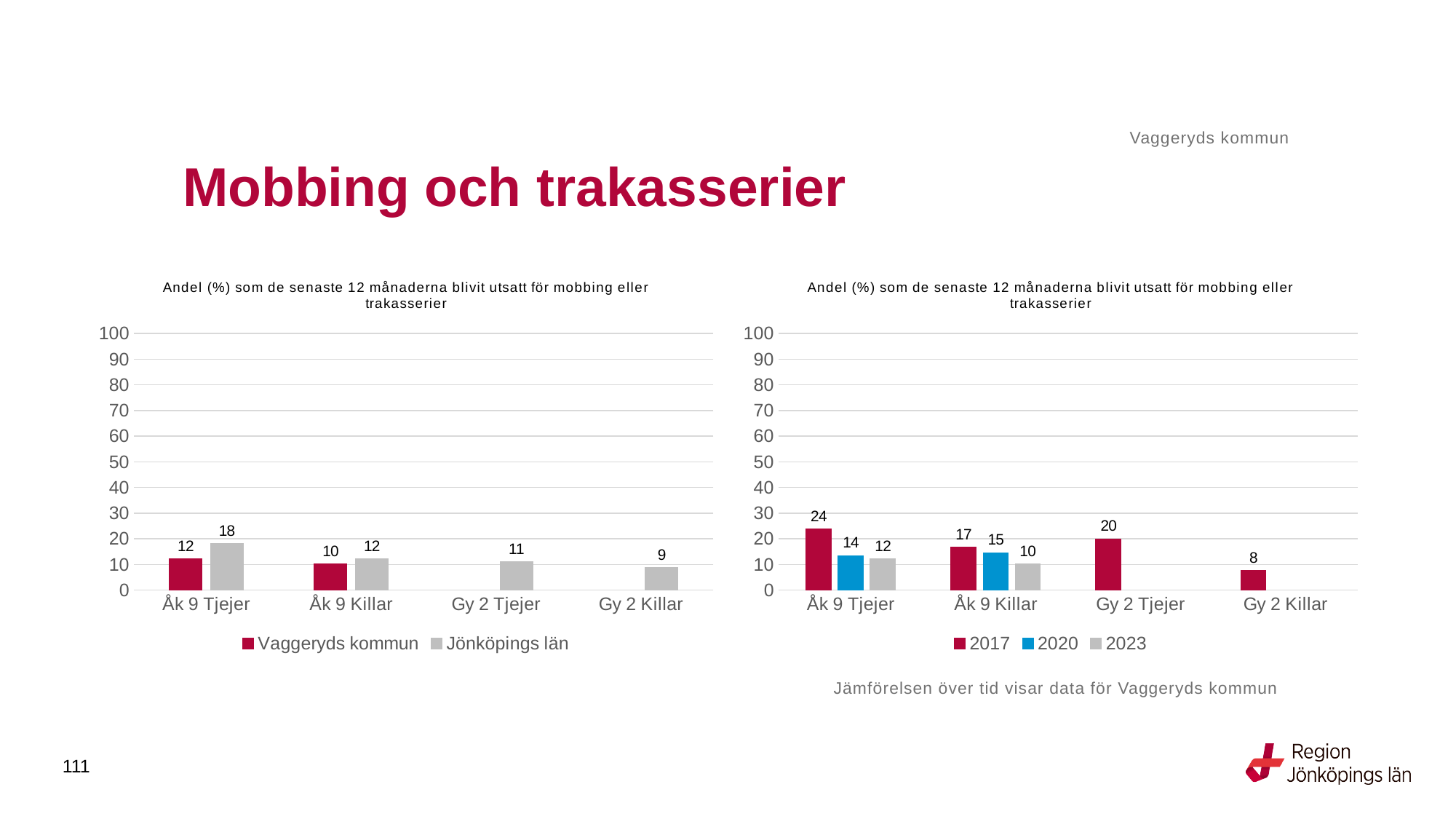
In the right chart, what is the value for 2023 for Åk 9 Killar? 10 In the left chart, how many series does the legend list? 2 In the right chart, which is larger for Åk 9 Killar: the 2020 value or the 2023 value? 2020 In the left chart, what is the value for Vaggeryds kommun for Åk 9 Killar? 10 In the right chart, how many series does the legend list? 3 In the left chart, what is the difference between Jönköpings län and Vaggeryds kommun for Åk 9 Tjejer? 6 What kind of chart is the left chart? Bar chart In the right chart, what is the difference between the 2017 and 2023 values for Åk 9 Tjejer? 12 In the right chart, what is the value for 2017 for Åk 9 Tjejer? 24 In the left chart, which category has the lowest value for Jönköpings län? Gy 2 Killar In the right chart, which category has the highest value for 2017? Åk 9 Tjejer In the left chart, what is the value for Jönköpings län for Åk 9 Tjejer? 18